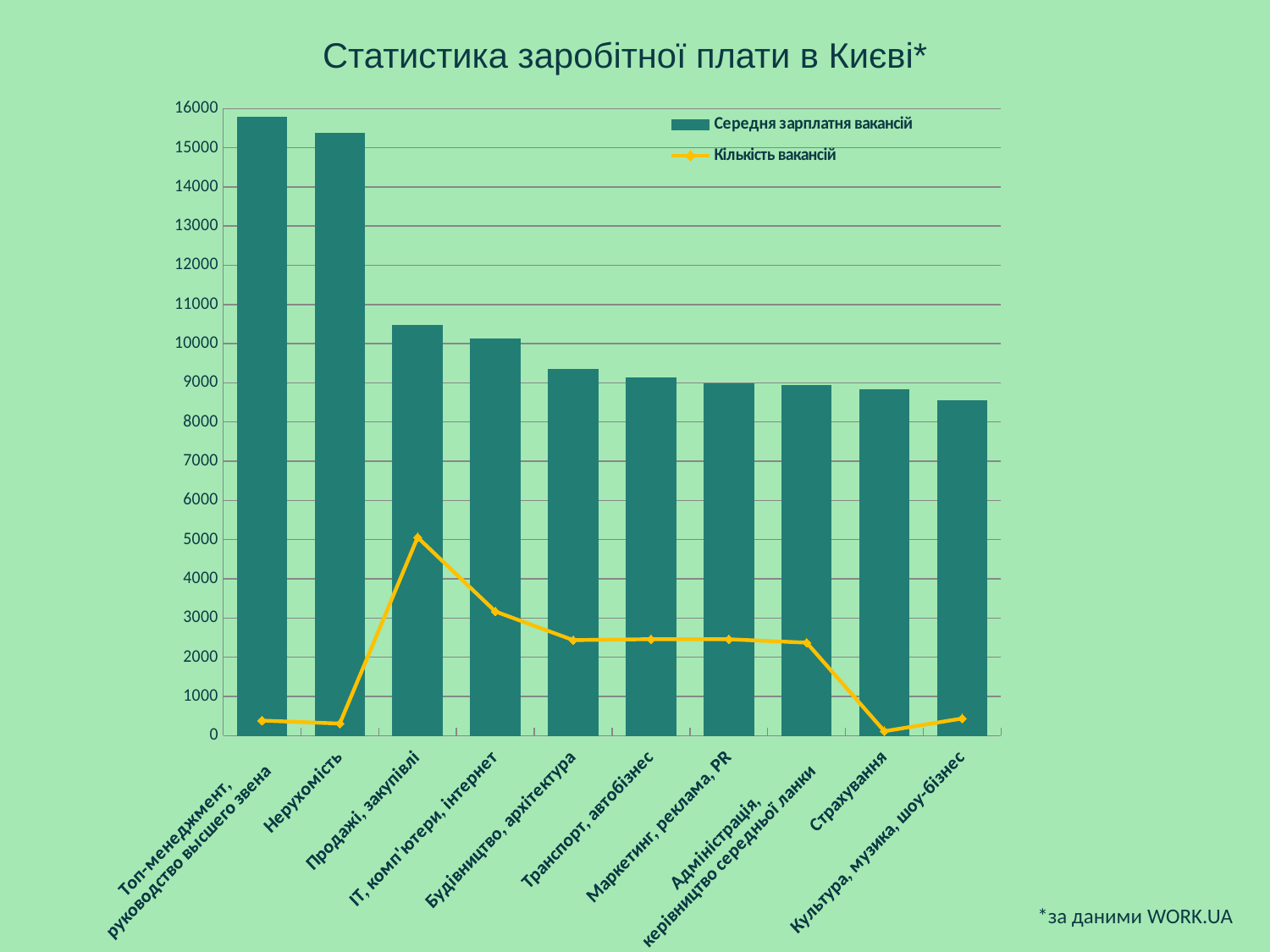
Which category has the highest bar for Середня зарплатня вакансій? Топ-менеджмент, руководство высшего звена How many categories are shown along the x axis? 10 Which category has the highest point on the Кількість вакансій line? Продажі, закупівлі Is the Середня зарплатня вакансій bar for Продажі, закупівлі greater or less than 10000? greater Which category has the lowest bar for Середня зарплатня вакансій? Культура, музика, шоу-бізнес Which has the larger Середня зарплатня вакансій bar: Нерухомість or Продажі, закупівлі? Нерухомість Is the Середня зарплатня вакансій bar for Будівництво, архітектура greater or less than 10000? less Which category has the lowest point on the Кількість вакансій line? Страхування What kind of chart is shown on the slide? A bar chart combined with a line chart How many series does the legend list? 2 Do the Середня зарплатня вакансій bars rise or fall from left to right along the x axis? fall Is the Кількість вакансій value for Нерухомість greater or less than 1000? less